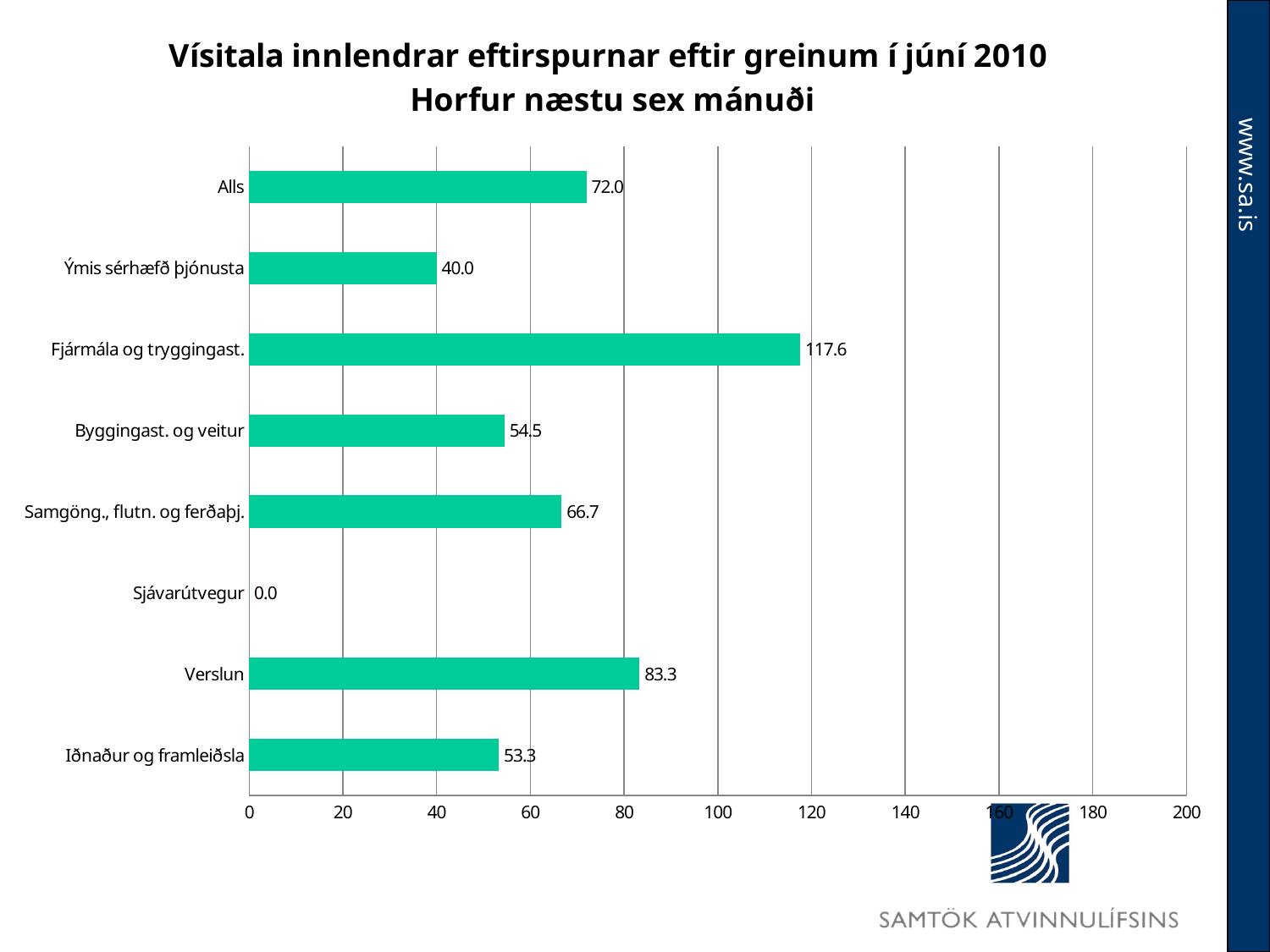
What is the value for Alls? 72.0 Which category has the highest value? Fjármála og tryggingast. What is the value for Sjávarútvegur? 0.0 Which category has the lowest value? Sjávarútvegur Which is larger, the value for Byggingast. og veitur or the value for Samgöng., flutn. og ferðaþj.? Samgöng., flutn. og ferðaþj. What is the value for Verslun? 83.3 What is the value for Fjármála og tryggingast.? 117.6 What is the title of the chart? Vísitala innlendrar eftirspurnar eftir greinum í júní 2010 Horfur næstu sex mánuði What kind of chart is shown on the slide? bar chart Is the value for Ýmis sérhæfð þjónusta greater or less than 60? less What is the difference between the values for Verslun and Iðnaður og framleiðsla? 30.0 How many categories are shown on the chart? 8